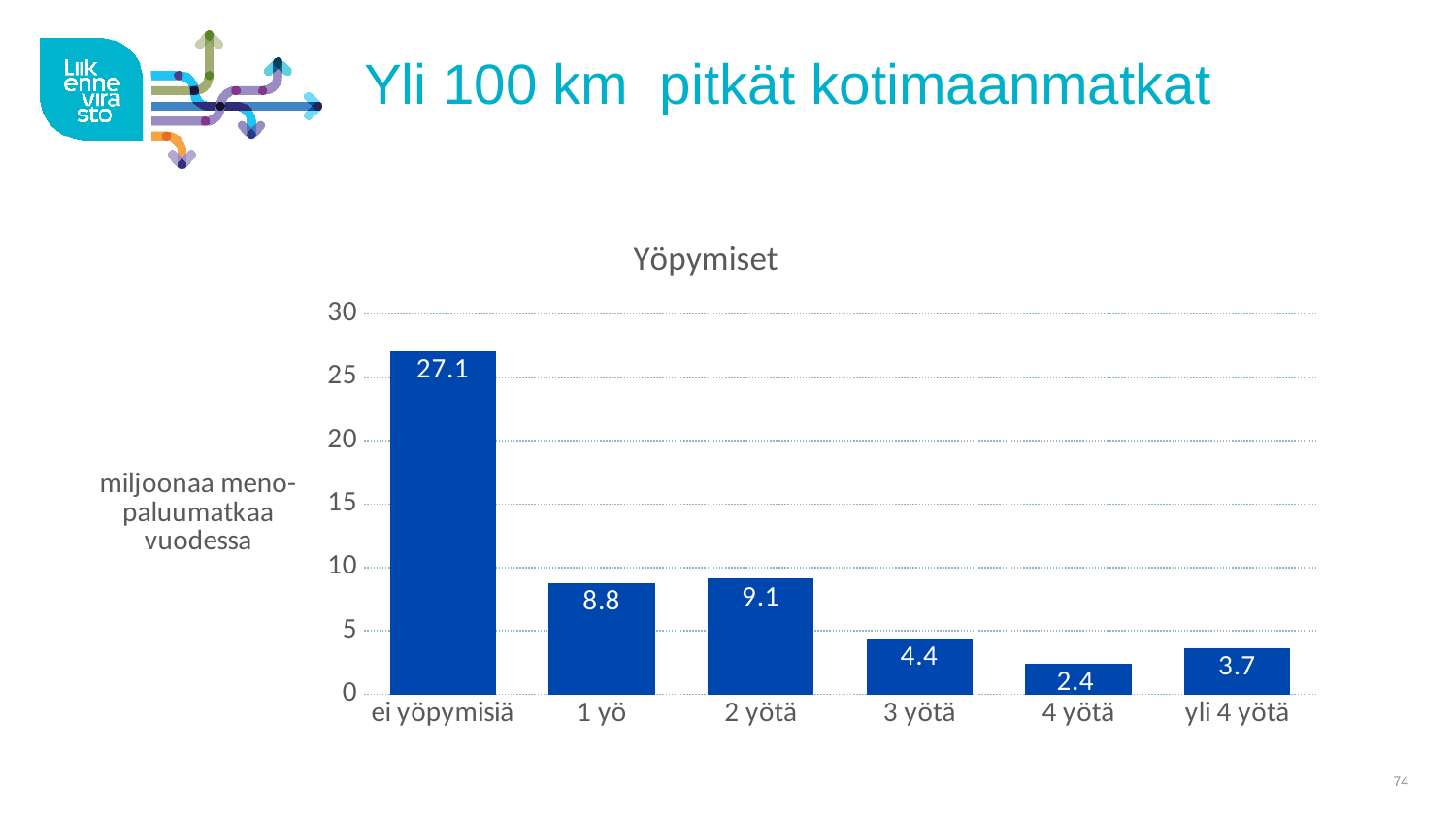
What is the value for 'yli 4 yötä'? 3.7 What is the value for '3 yötä'? 4.4 What kind of chart is shown on the slide? bar chart What is the difference between the values for '2 yötä' and '4 yötä'? 6.7 How many categories are shown on the x axis? 6 Is the value for '1 yö' greater or less than 10? less What is the title of the chart? Yöpymiset Which is larger, the value for '1 yö' or the value for '2 yötä'? 2 yötä What is the difference between the values for 'ei yöpymisiä' and '1 yö'? 18.3 Which category has the highest value? ei yöpymisiä Which category has the lowest value? 4 yötä What is the value for 'ei yöpymisiä'? 27.1